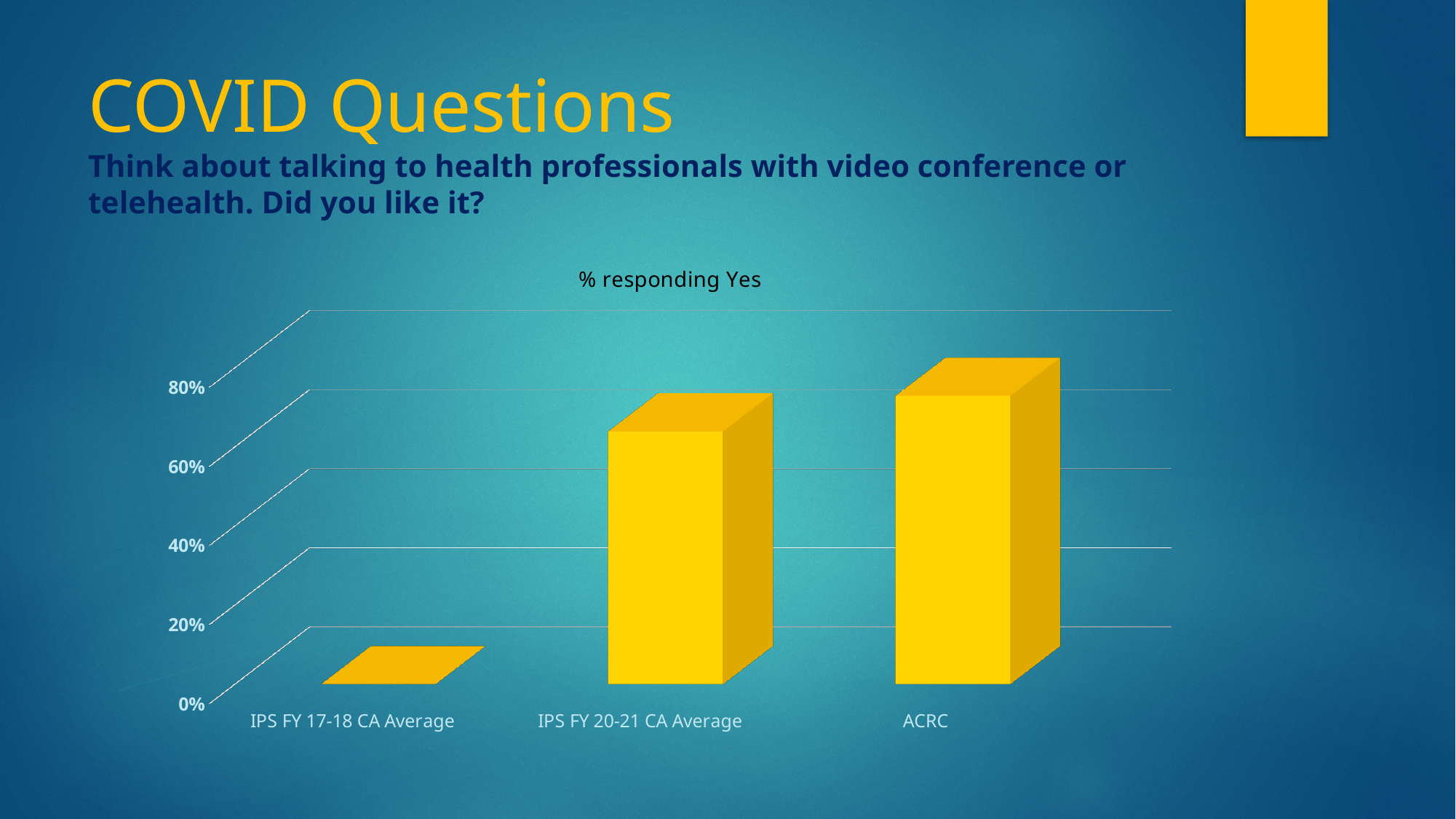
Is the value for ACRC greater or less than 60%? greater What type of chart is shown on the slide? bar chart What is the highest value labelled on the vertical axis of the chart? 80% Which category has the lowest value in the chart? IPS FY 17-18 CA Average Which is larger, the value for IPS FY 17-18 CA Average or the value for IPS FY 20-21 CA Average? IPS FY 20-21 CA Average Which category has the highest value in the chart? ACRC What is the title of the chart? % responding Yes Is the value for IPS FY 20-21 CA Average greater or less than 40%? greater Which is larger, the value for ACRC or the value for IPS FY 20-21 CA Average? ACRC How many categories are shown on the x axis of the chart? 3 Is the value for IPS FY 17-18 CA Average greater or less than 20%? less Do the values rise or fall from left to right across the categories? rise